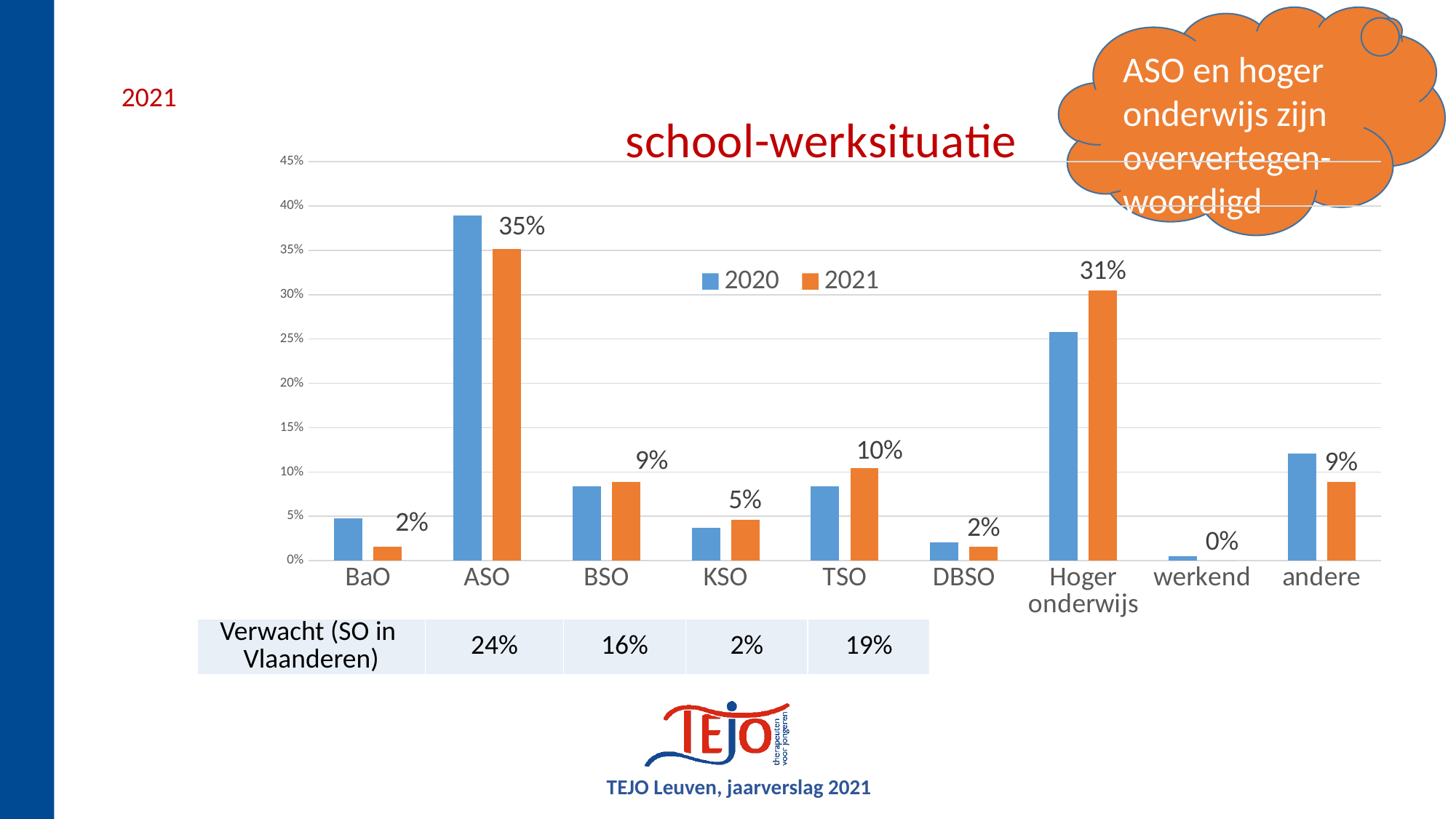
For ASO, which series is larger, 2020 or 2021? 2020 Which has the larger 2021 value, TSO or BSO? TSO What is the 2021 value for KSO? 5% What is the 2021 value for Hoger onderwijs? 31% What kind of chart is shown on the slide? bar chart Is the 2020 value for andere greater or less than 10%? greater How many series does the legend list? 2 What is the 2021 value for ASO? 35% How many categories are shown on the x axis? 9 Which category has the highest 2021 value? ASO What is the difference between the 2021 values for ASO and Hoger onderwijs? 4 percentage points Which category has the lowest 2021 value? werkend